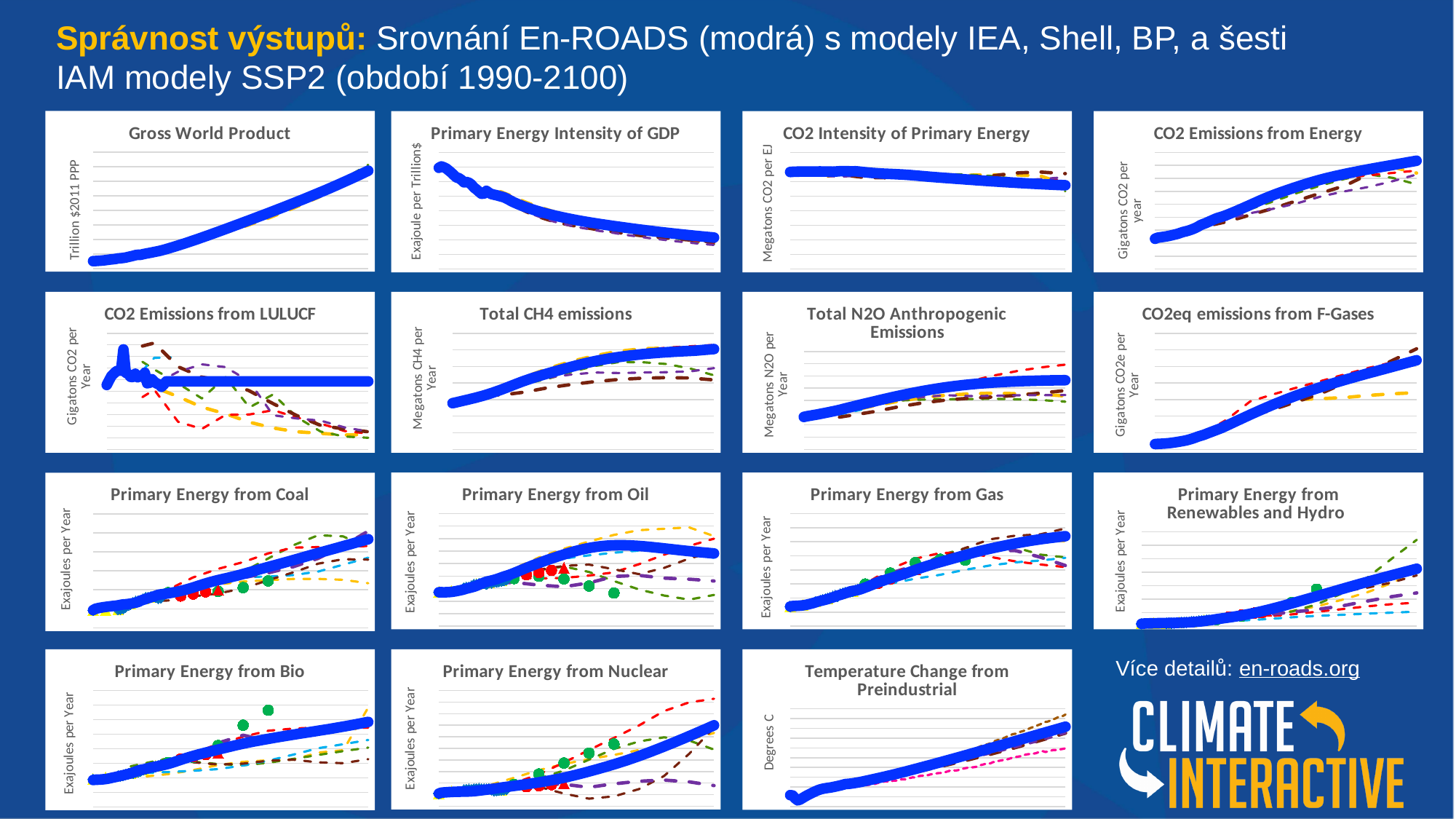
In the "Total CH4 emissions" chart, does the thick blue line rise or fall along the x axis? rises In the "Primary Energy from Oil" chart, what is the overall shape of the thick blue line along the x axis? rises then falls In the "Primary Energy from Renewables and Hydro" chart, does the thick blue line rise or fall along the x axis? rises How many small charts are shown on the slide? 15 What is the y-axis label of the "Temperature Change from Preindustrial" chart? Degrees C What kind of chart is the "Gross World Product" chart? line chart